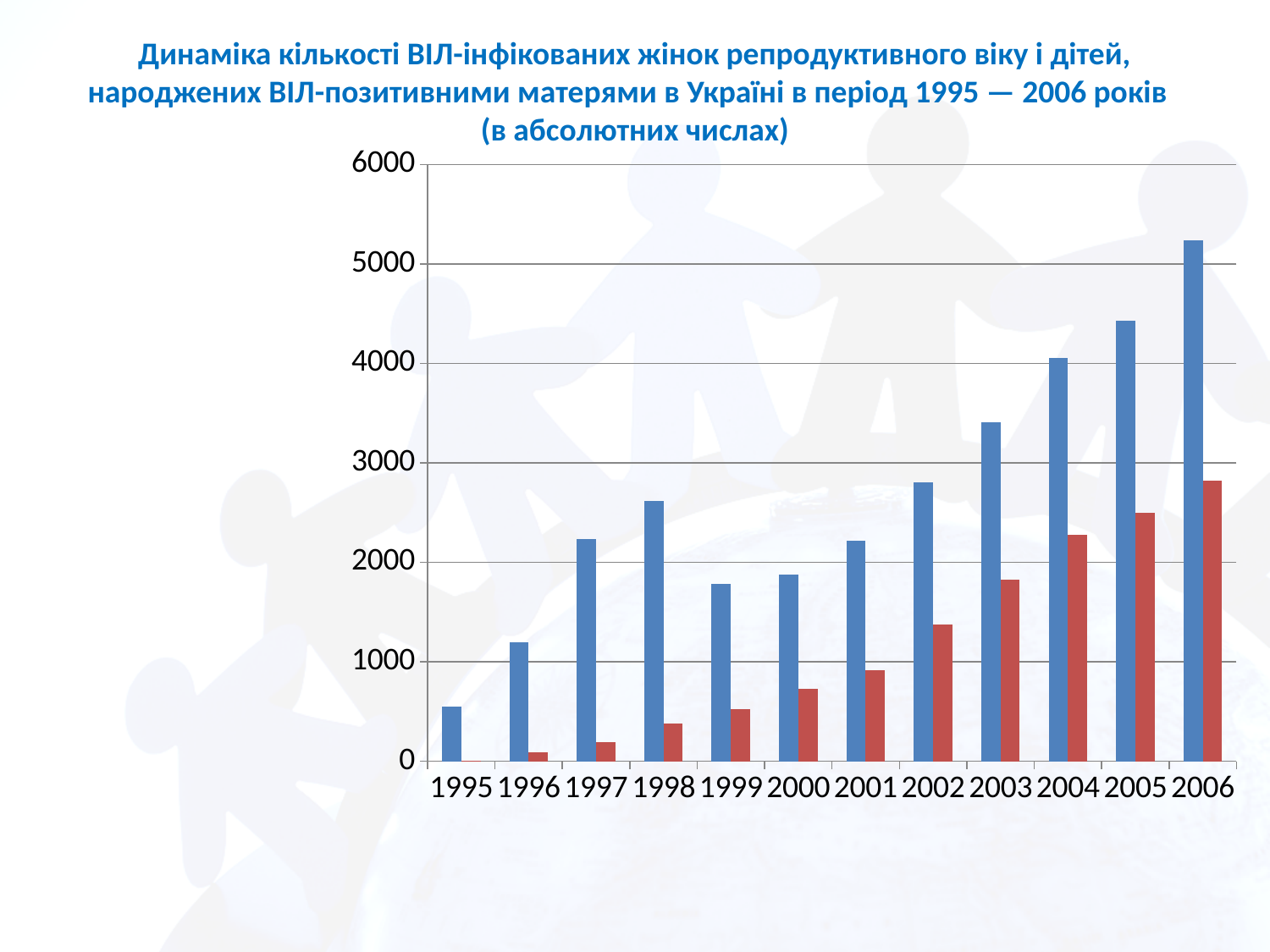
Do the blue bars rise or fall from 2000 to 2006? rise In which year is the blue bar the shortest? 1995 What type of chart is shown on the slide? bar chart Is the value of the blue bar for 2006 greater or less than 5000? greater Is the value of the blue bar for 1995 greater or less than 1000? less Which is larger, the blue bar for 1998 or the blue bar for 1999? 1998 In which year is the blue bar the tallest? 2006 How many years are shown on the x axis of the chart? 12 In which year is the red bar the tallest? 2006 How many data series (bar colours) are plotted in the chart? 2 Is the value of the red bar for 2006 greater or less than 3000? less